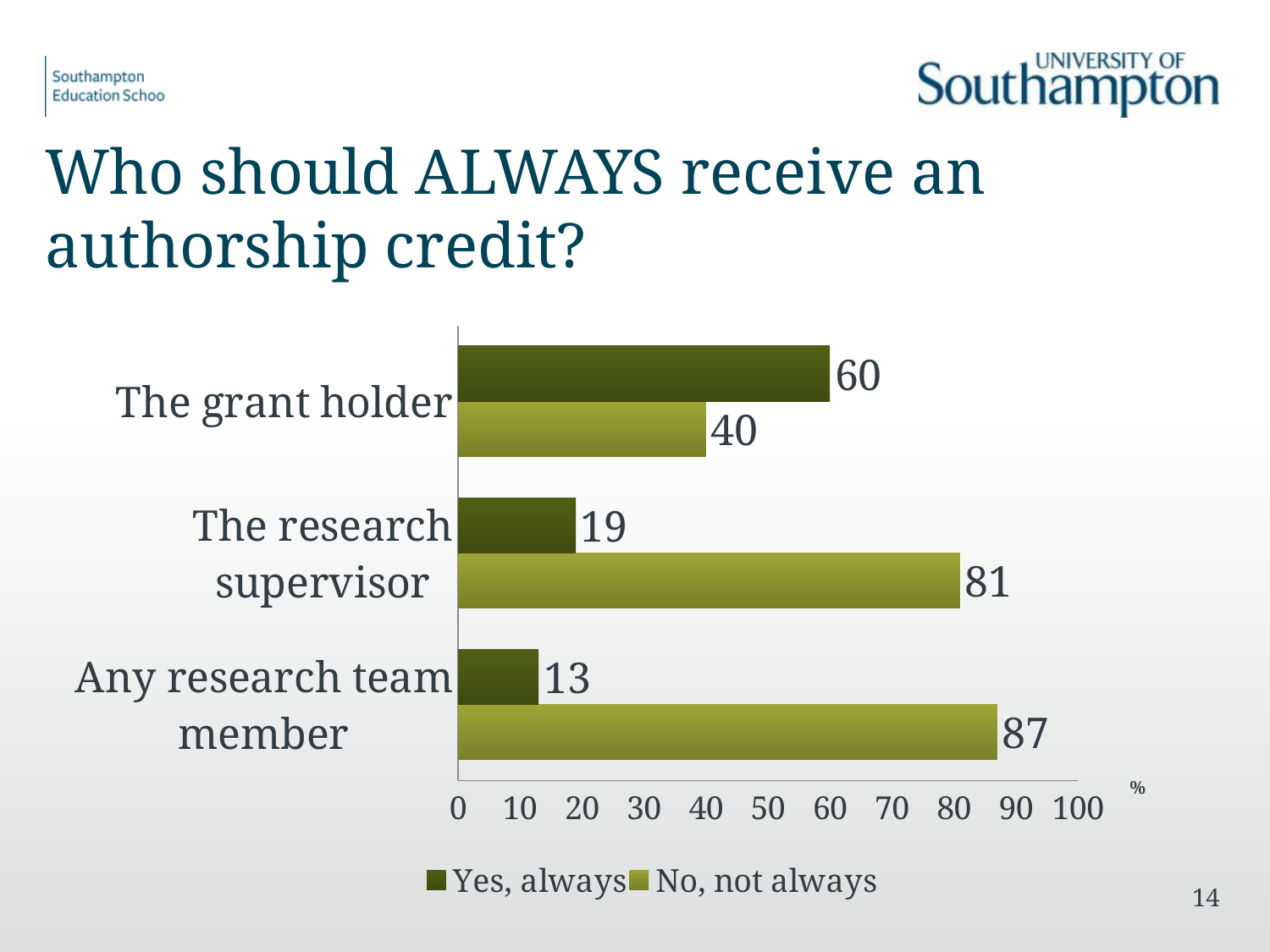
How many categories are shown on the chart? 3 What unit is shown at the end of the horizontal axis? % Which category has the highest 'No, not always' value? Any research team member How many series does the legend list? 2 What is the difference between the 'No, not always' and 'Yes, always' values for The research supervisor? 62 What kind of chart is shown on the slide? Bar chart Which category has the lowest 'Yes, always' value? Any research team member Which is larger for The grant holder: 'Yes, always' or 'No, not always'? Yes, always What is the 'Yes, always' value for Any research team member? 13 What is the 'No, not always' value for The research supervisor? 81 What is the 'Yes, always' value for The grant holder? 60 Is the 'No, not always' value for The grant holder greater or less than 50? less